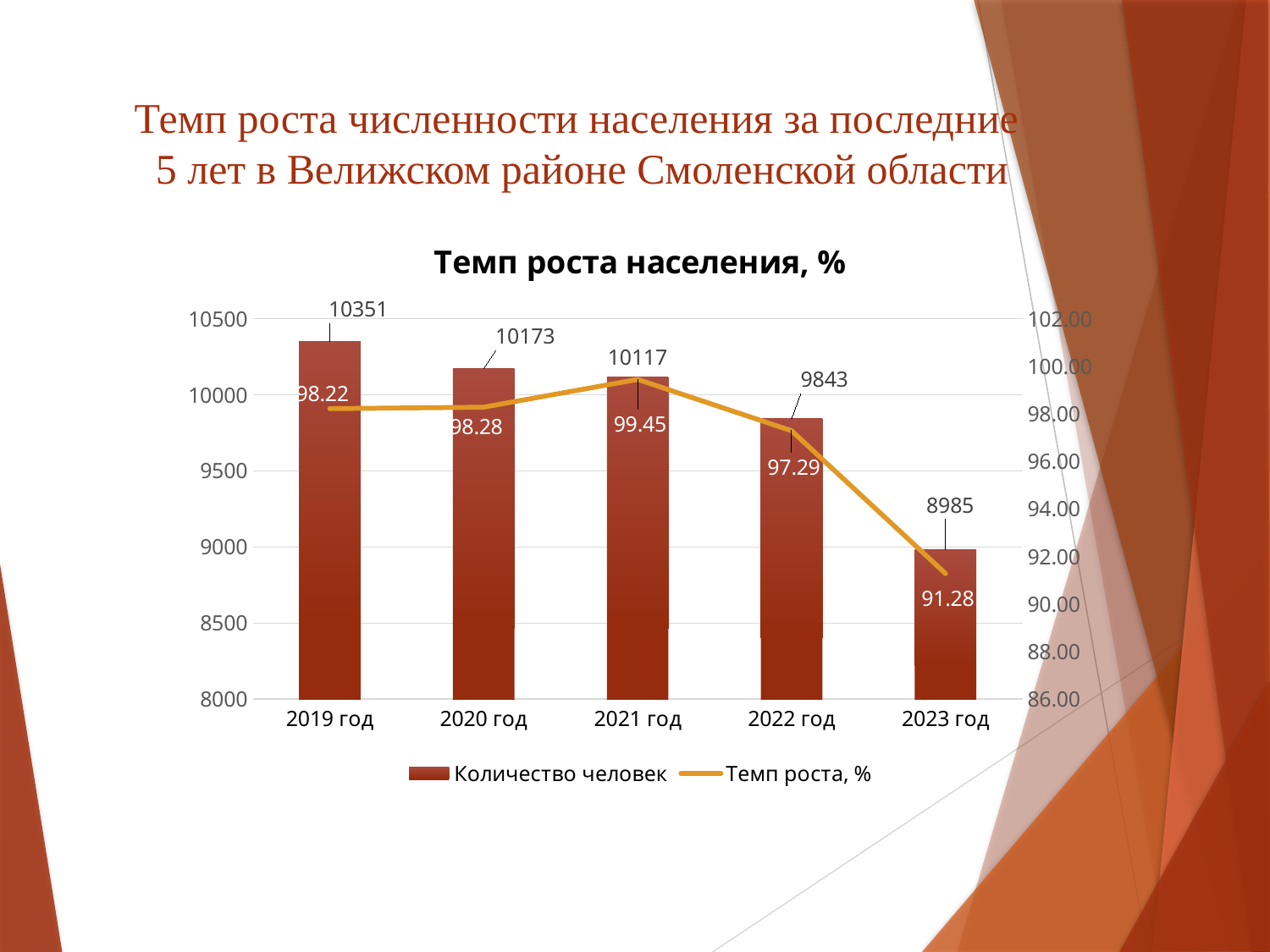
Does Количество человек rise or fall from 2019 год to 2023 год? fall How many series does the legend list? 2 What kind of chart is used for the Количество человек series? bar chart Which year has the lowest Темп роста, %? 2023 год What is the value of Темп роста, % for 2021 год? 99.45 What is the title of the chart? Темп роста населения, % What is the difference in Количество человек between 2019 год and 2023 год? 1366 What is the value of Количество человек for 2023 год? 8985 Which is larger, Темп роста, % for 2020 год or for 2022 год? 2020 год How many years are shown on the x axis? 5 Which year has the highest Количество человек? 2019 год What is the value of Количество человек for 2019 год? 10351